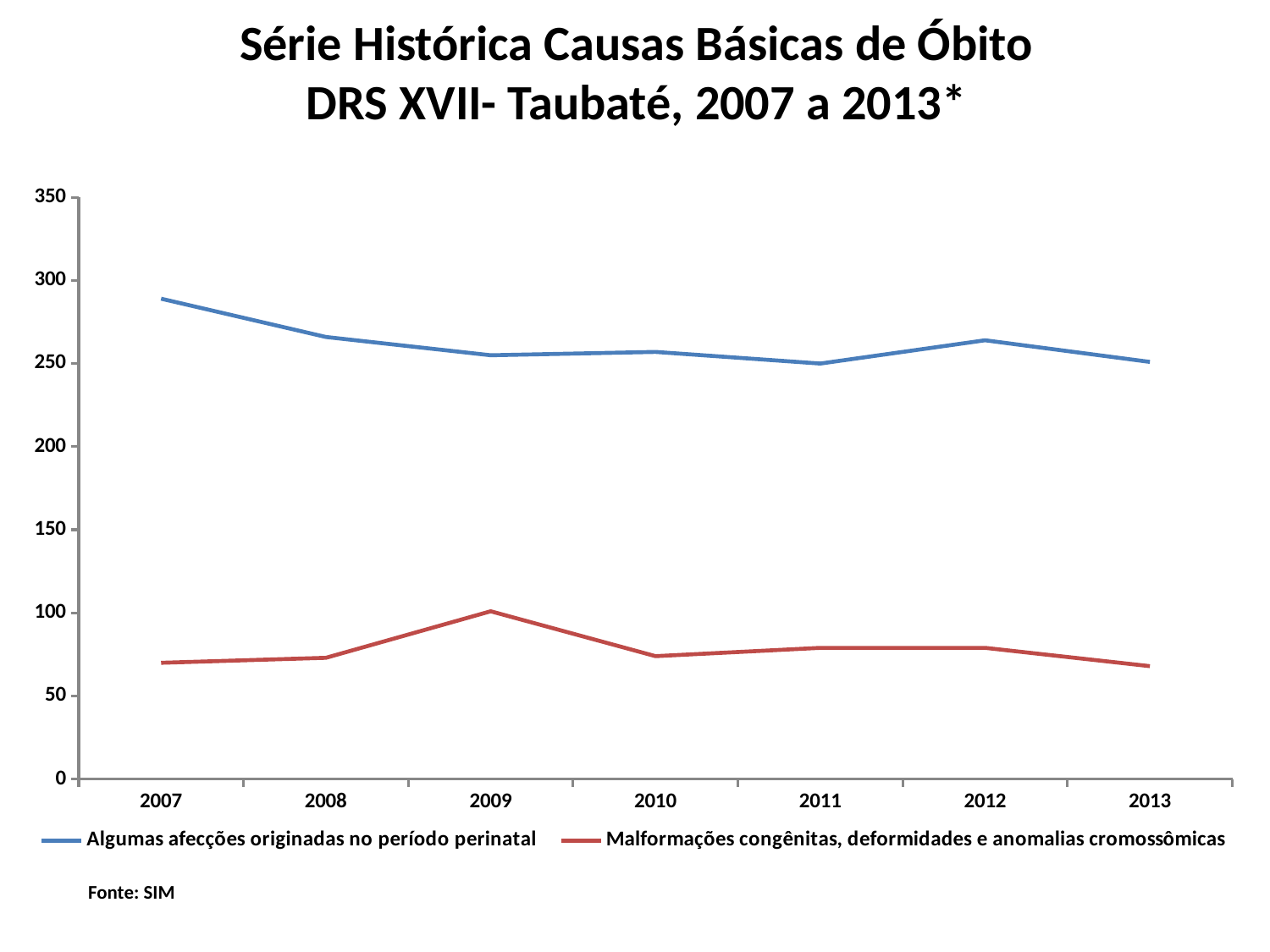
Does the value for 'Algumas afecções originadas no período perinatal' rise or fall from 2007 to 2009? fall Which colour is used for the 'Malformações congênitas, deformidades e anomalias cromossômicas' line? red Which is larger for 'Algumas afecções originadas no período perinatal': the value in 2007 or the value in 2013? 2007 How many years are plotted along the x axis? 7 Is the 2013 value for 'Malformações congênitas, deformidades e anomalias cromossômicas' greater or less than 100? less Is the 2011 value for 'Algumas afecções originadas no período perinatal' greater or less than 300? less How many series does the legend list? 2 In which year is the value for 'Malformações congênitas, deformidades e anomalias cromossômicas' highest? 2009 Which series has the larger value in 2009: 'Algumas afecções originadas no período perinatal' or 'Malformações congênitas, deformidades e anomalias cromossômicas'? Algumas afecções originadas no período perinatal In which year is the value for 'Algumas afecções originadas no período perinatal' highest? 2007 Is the 2007 value for 'Algumas afecções originadas no período perinatal' greater or less than 250? greater What kind of chart is shown on the slide? line chart